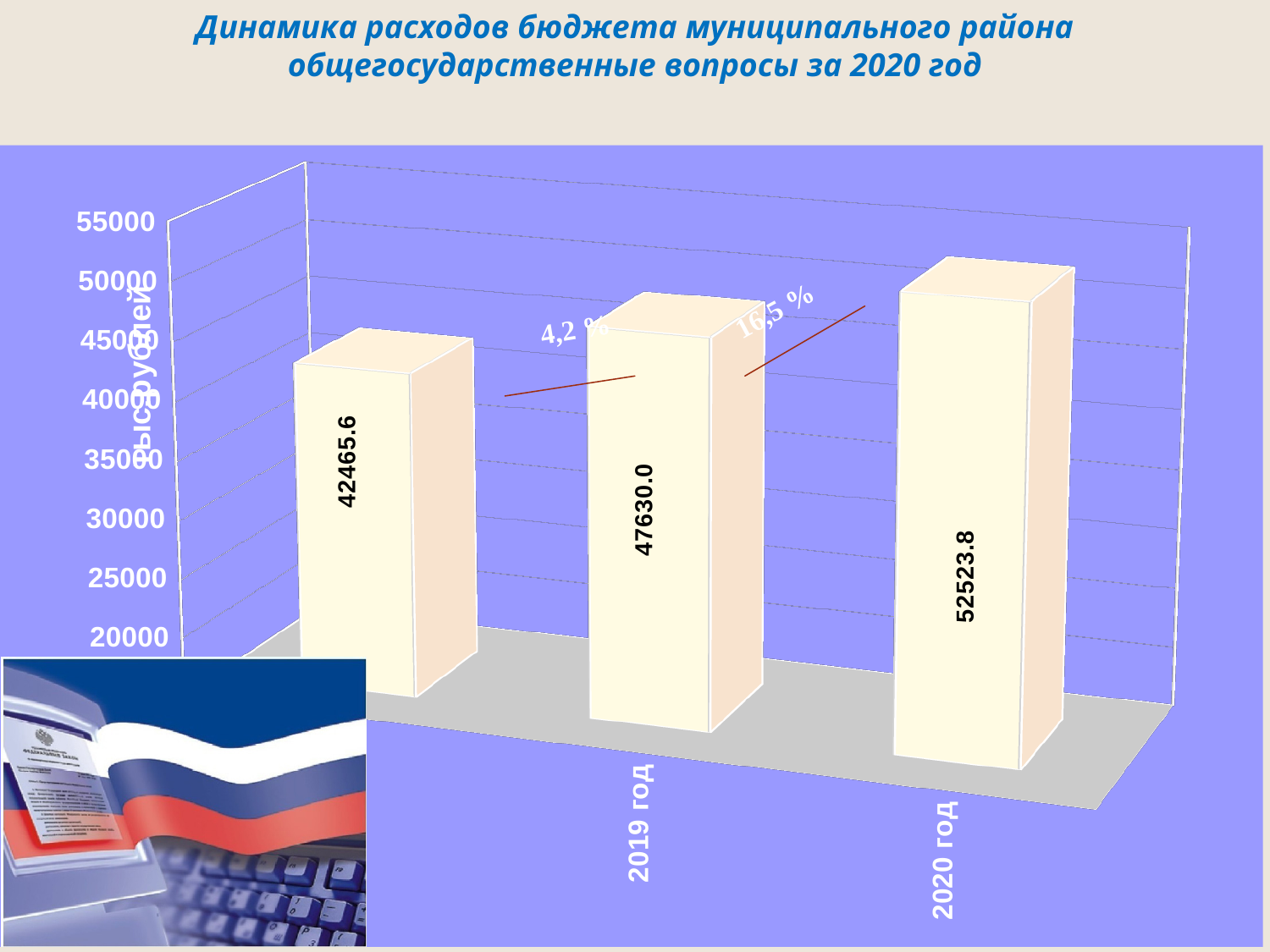
Do the values rise or fall from left to right across the bars? Rise Which year has the highest value? 2020 год Is the value for 2019 год greater or less than 45000? greater What is the value for 2020 год? 52523.8 What is the smallest value shown on the chart? 42465.6 What value is printed on the leftmost bar? 42465.6 What is the value for 2019 год? 47630.0 How many bars are shown on the chart? 3 What percentage is annotated between the 2019 год and 2020 год bars? 16,5 % Which is larger, the value for 2019 год or for 2020 год? 2020 год What kind of chart is shown on the slide? Bar chart What is the difference between the values for 2020 год and 2019 год? 4893.8